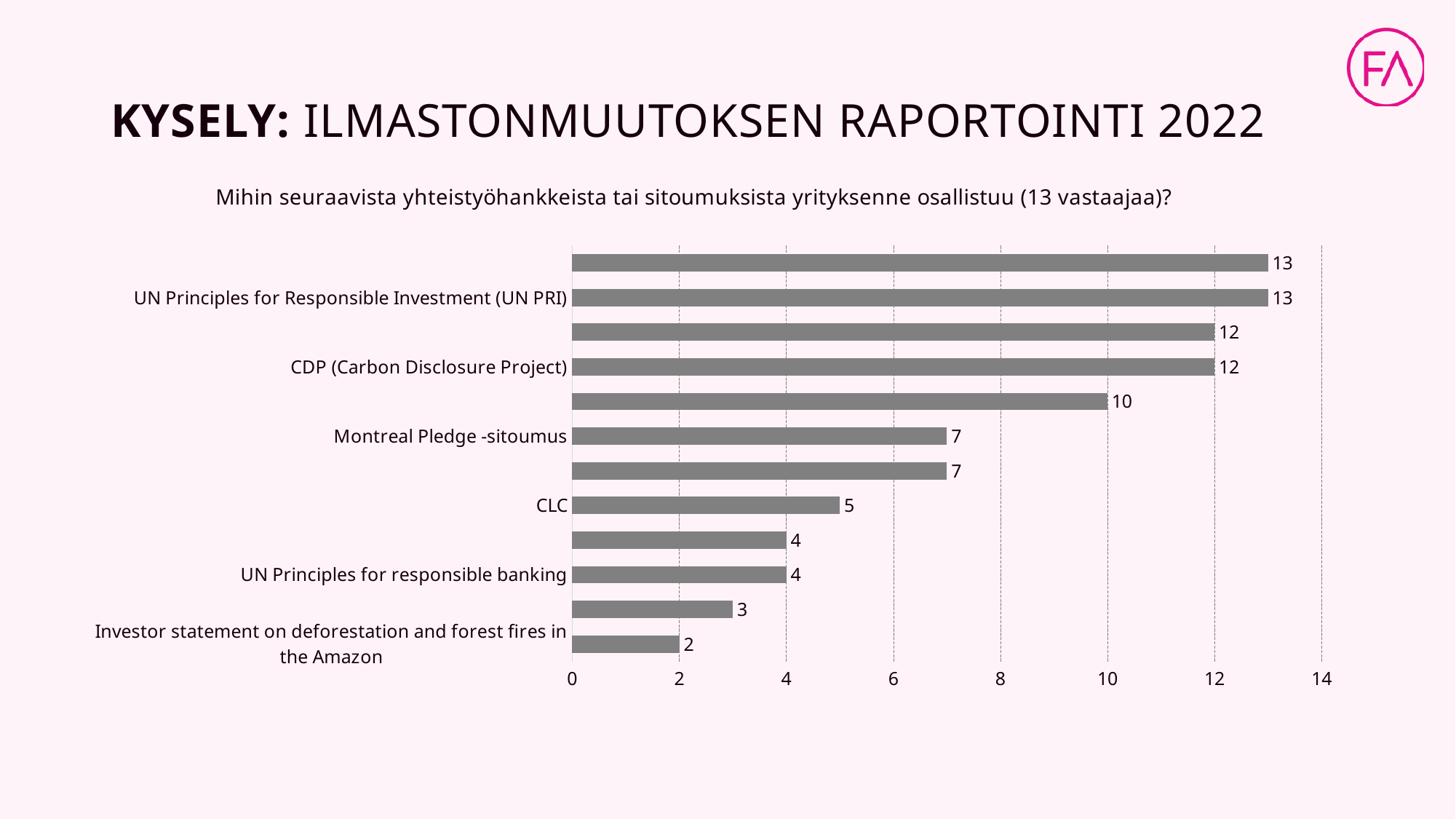
What value is shown for CLC? 5 What value is shown for UN Principles for Responsible Investment (UN PRI)? 13 Which is larger, the value for UN Principles for Responsible Investment (UN PRI) or the value for CDP (Carbon Disclosure Project)? UN Principles for Responsible Investment (UN PRI) What is the difference between the values for CDP (Carbon Disclosure Project) and Montreal Pledge -sitoumus? 5 What value is shown for Montreal Pledge -sitoumus? 7 What is the highest value shown on the x axis? 14 How many bars are plotted in the chart? 12 What value is shown for UN Principles for responsible banking? 4 What value is shown for CDP (Carbon Disclosure Project)? 12 What kind of chart is shown on the slide? bar chart What value is shown for Investor statement on deforestation and forest fires in the Amazon? 2 Which labelled category has the lowest value? Investor statement on deforestation and forest fires in the Amazon